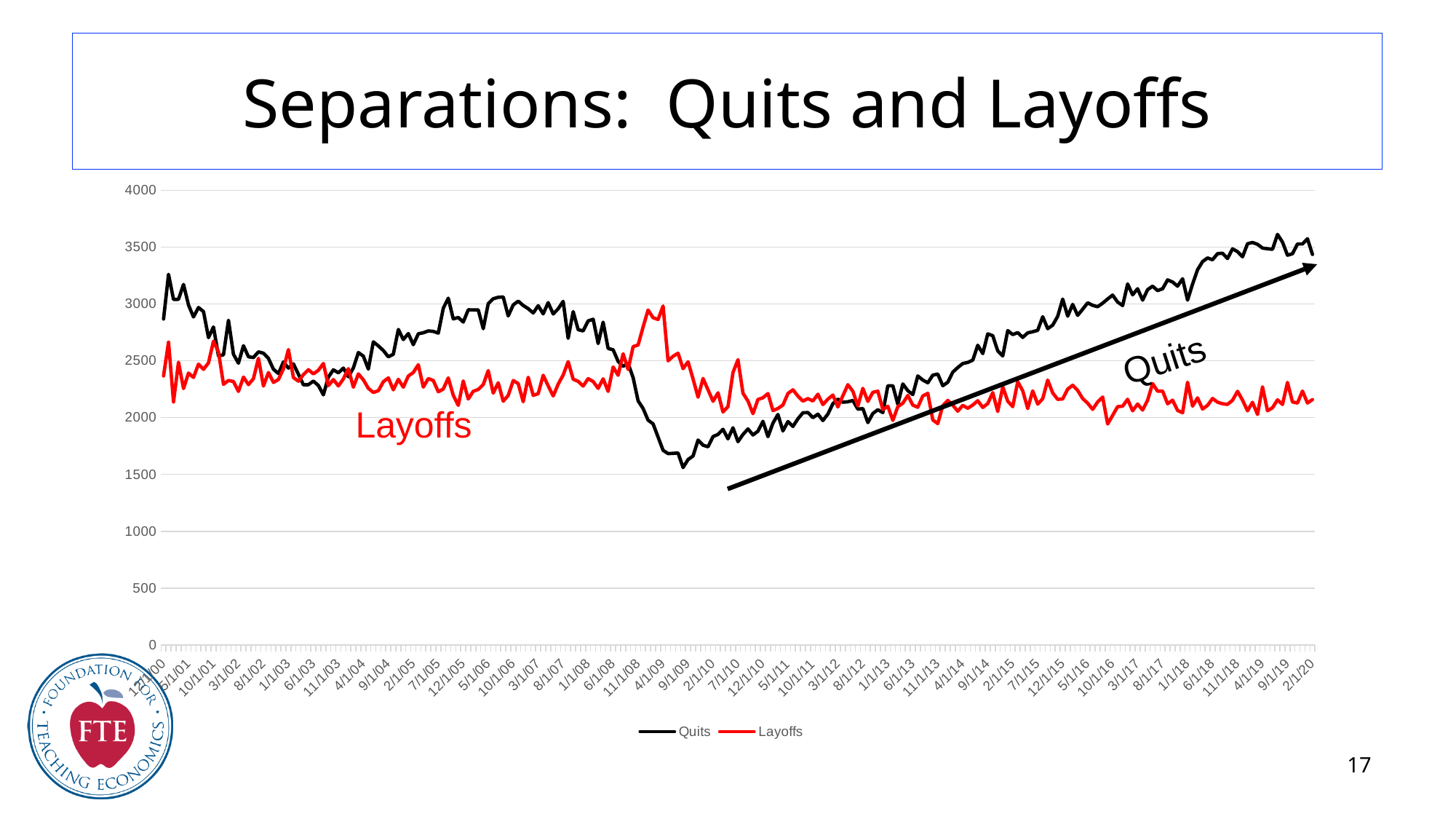
At 2/1/20, which series has the larger value, Quits or Layoffs? Quits Around 9/1/09, which series has the larger value, Quits or Layoffs? Layoffs Do Quits rise or fall from 2010 to 2020? Rise Is the value for Quits around 9/1/09 greater or less than 2000? less Is the peak value for Layoffs around 4/1/09 greater or less than 2500? greater Which series reaches the highest value anywhere on the chart? Quits Is the value for Layoffs at 2/1/20 greater or less than 2500? less What kind of chart is shown on the slide? Line chart How many series does the legend list? 2 What colour is the Layoffs line? Red What is the title of the slide's chart? Separations: Quits and Layoffs